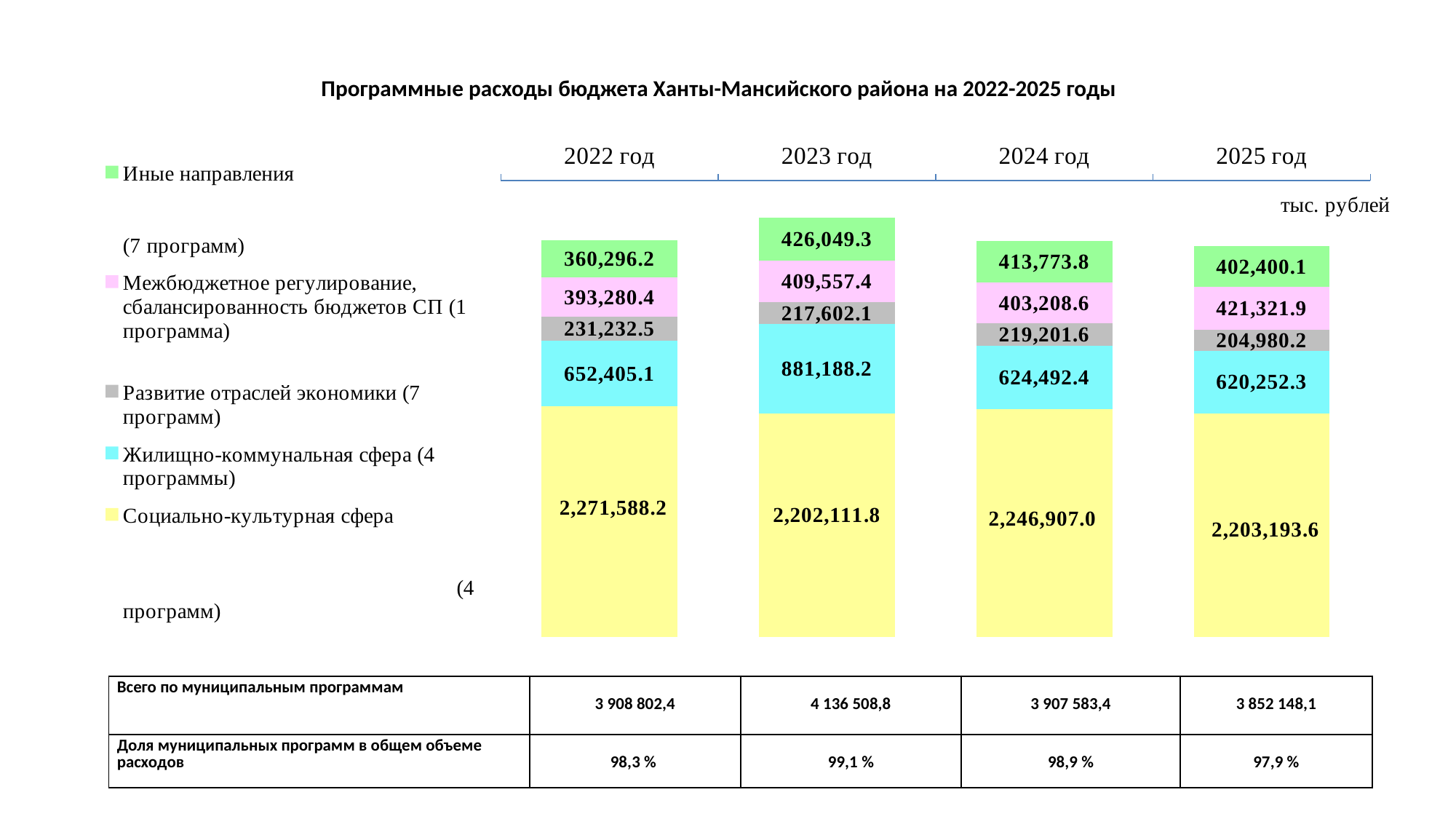
What is the value for Развитие отраслей экономики in 2022 год? 231,232.5 What kind of chart is shown on the slide? Stacked bar chart What is the difference between the Жилищно-коммунальная сфера values for 2023 год and 2022 год? 228,783.1 What colour represents Социально-культурная сфера in the chart? Yellow Which is larger in 2025 год: Межбюджетное регулирование, сбалансированность бюджетов СП or Иные направления? Межбюджетное регулирование, сбалансированность бюджетов СП In which year is the value for Иные направления the highest? 2023 год How many years (bars) are shown in the chart? 4 What is the total of the stacked bar for 2022 год? 3 908 802,4 What is the value for Жилищно-коммунальная сфера in 2023 год? 881,188.2 What is the value for Социально-культурная сфера in 2025 год? 2,203,193.6 How many series does the legend list? 5 In which year is the value for Развитие отраслей экономики the lowest? 2025 год